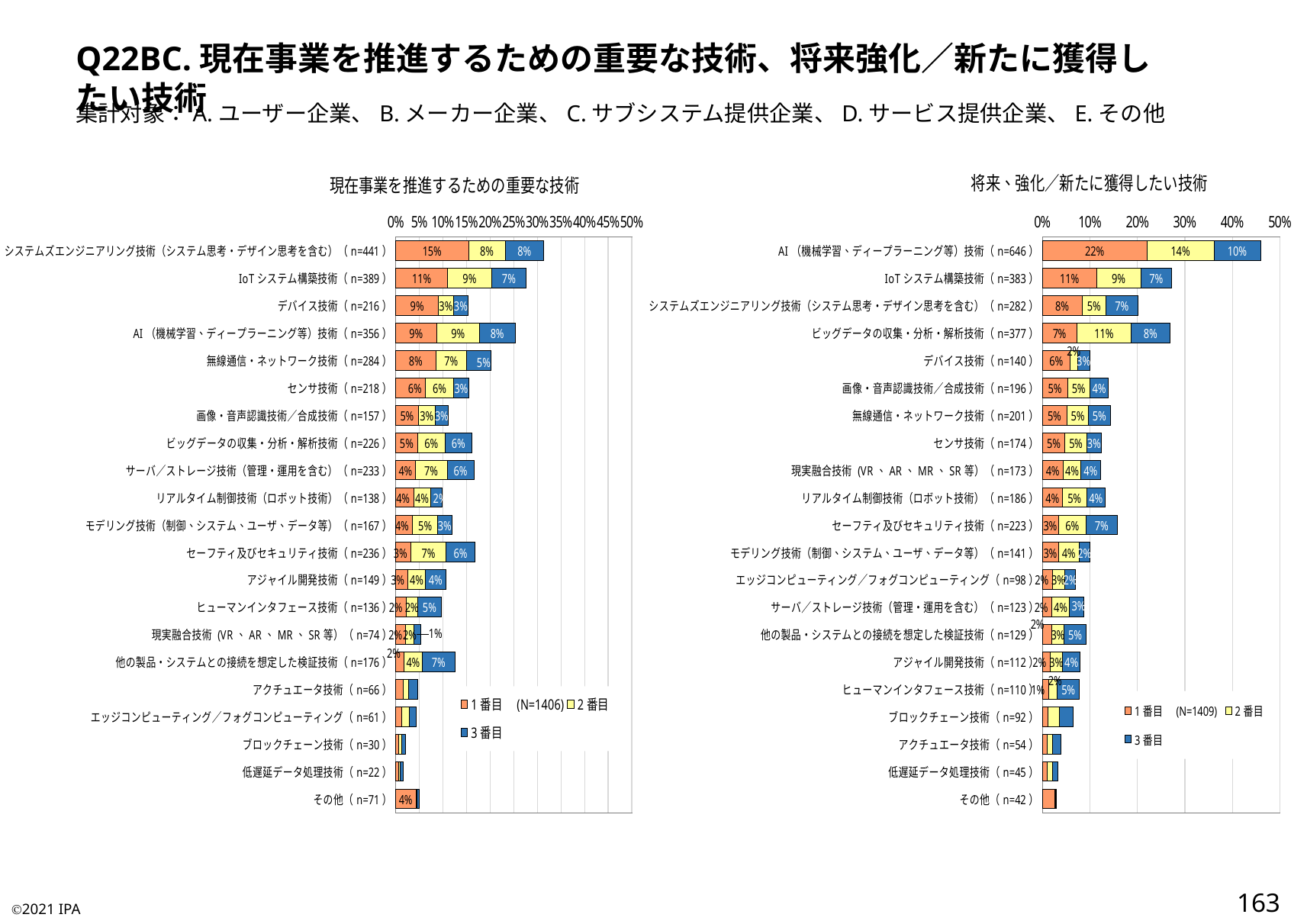
In the right chart (将来、強化／新たに獲得したい技術), what is the total of the stacked bar for AI（機械学習、ディープラーニング等）技術? 46% In the left chart (現在事業を推進するための重要な技術), which category has the longest total bar? システムズエンジニアリング技術（システム思考・デザイン思考を含む） In the left chart (現在事業を推進するための重要な技術), what is the 1番目 value for システムズエンジニアリング技術? 15% In the right chart (将来、強化／新たに獲得したい技術), which category has the longest total bar? AI（機械学習、ディープラーニング等）技術 In the right chart (将来、強化／新たに獲得したい技術), what is the 1番目 value for AI（機械学習、ディープラーニング等）技術? 22% What kind of chart is the right chart (将来、強化／新たに獲得したい技術)? Stacked bar chart In the right chart (将来、強化／新たに獲得したい技術), which has the larger 1番目 value: AI技術 or IoTシステム構築技術? AI（機械学習、ディープラーニング等）技術 How many series does the legend of the left chart list? 3 In the left chart (現在事業を推進するための重要な技術), what is the difference between the 1番目 values for システムズエンジニアリング技術 and IoTシステム構築技術? 4 percentage points In the left chart (現在事業を推進するための重要な技術), what is the total of the stacked bar for システムズエンジニアリング技術? 31% In the left chart (現在事業を推進するための重要な技術), what is the 3番目 value for IoTシステム構築技術? 7% In the right chart (将来、強化／新たに獲得したい技術), what is the 2番目 value for ビッグデータの収集・分析・解析技術? 11%